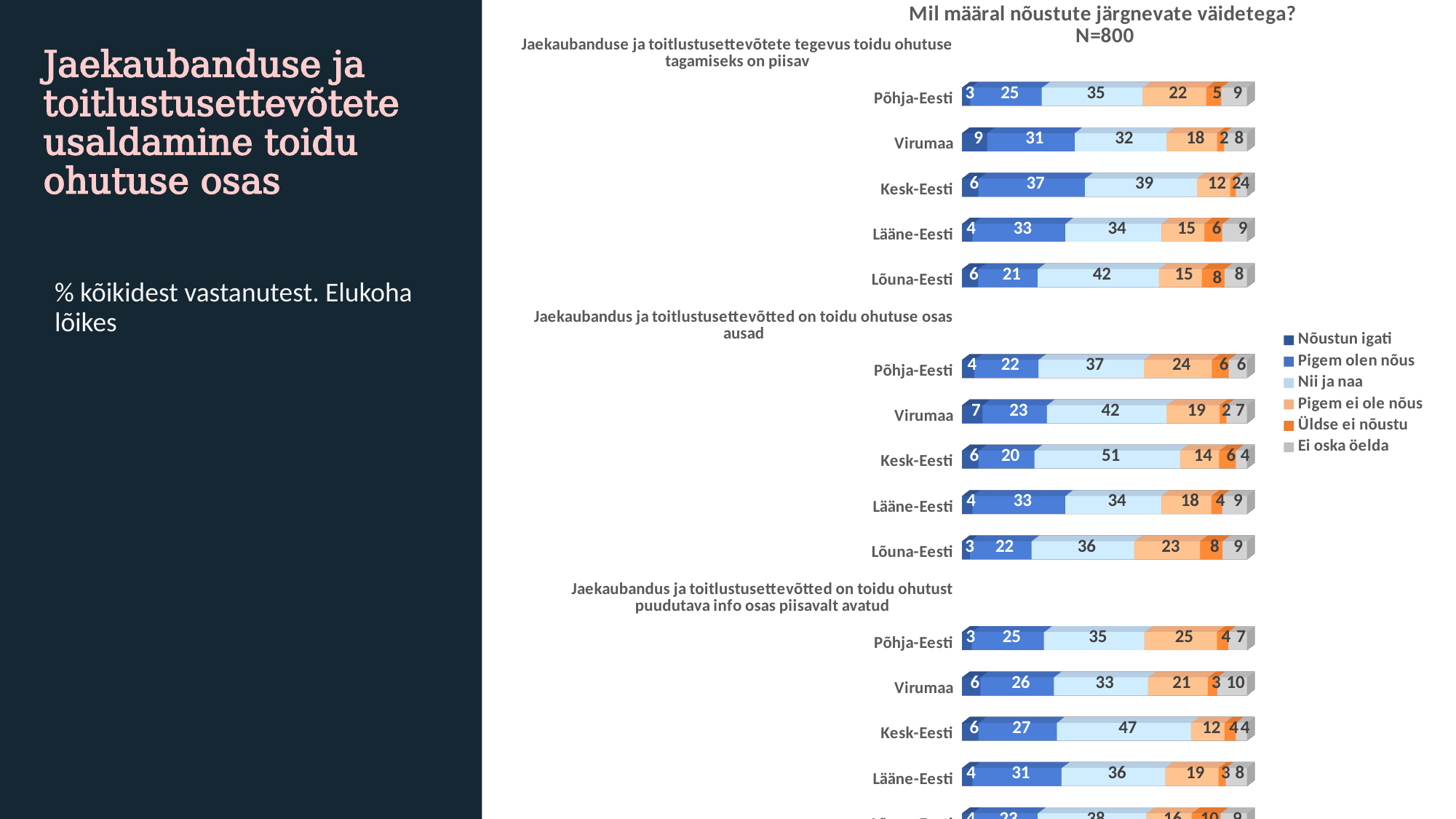
How many series does the legend list? 6 For the statement 'Jaekaubanduse ja toitlustusettevõtete tegevus toidu ohutuse tagamiseks on piisav', what is the difference between the 'Pigem olen nõus' values for Kesk-Eesti and Lõuna-Eesti? 16 For the statement 'Jaekaubandus ja toitlustusettevõtted on toidu ohutust puudutava info osas piisavalt avatud', what is the difference between the 'Nii ja naa' values for Kesk-Eesti and Virumaa? 14 How many regions are listed under each statement in the chart? 5 For the statement 'Jaekaubandus ja toitlustusettevõtted on toidu ohutuse osas ausad', which is larger: the 'Pigem ei ole nõus' value for Põhja-Eesti or for Kesk-Eesti? Põhja-Eesti For the statement 'Jaekaubandus ja toitlustusettevõtted on toidu ohutuse osas ausad', which region has the lowest 'Pigem olen nõus' value? Kesk-Eesti What sample size (N) is stated in the chart title? N=800 For the statement 'Jaekaubandus ja toitlustusettevõtted on toidu ohutust puudutava info osas piisavalt avatud', what is the 'Ei oska öelda' value for Virumaa? 10 For the statement 'Jaekaubanduse ja toitlustusettevõtete tegevus toidu ohutuse tagamiseks on piisav', what is the 'Nii ja naa' value for Lõuna-Eesti? 42 For the statement 'Jaekaubanduse ja toitlustusettevõtete tegevus toidu ohutuse tagamiseks on piisav', which region has the highest 'Nõustun igati' value? Virumaa For the statement 'Jaekaubandus ja toitlustusettevõtted on toidu ohutuse osas ausad', what is the 'Nii ja naa' value for Kesk-Eesti? 51 What kind of chart is shown on the slide? Stacked bar chart